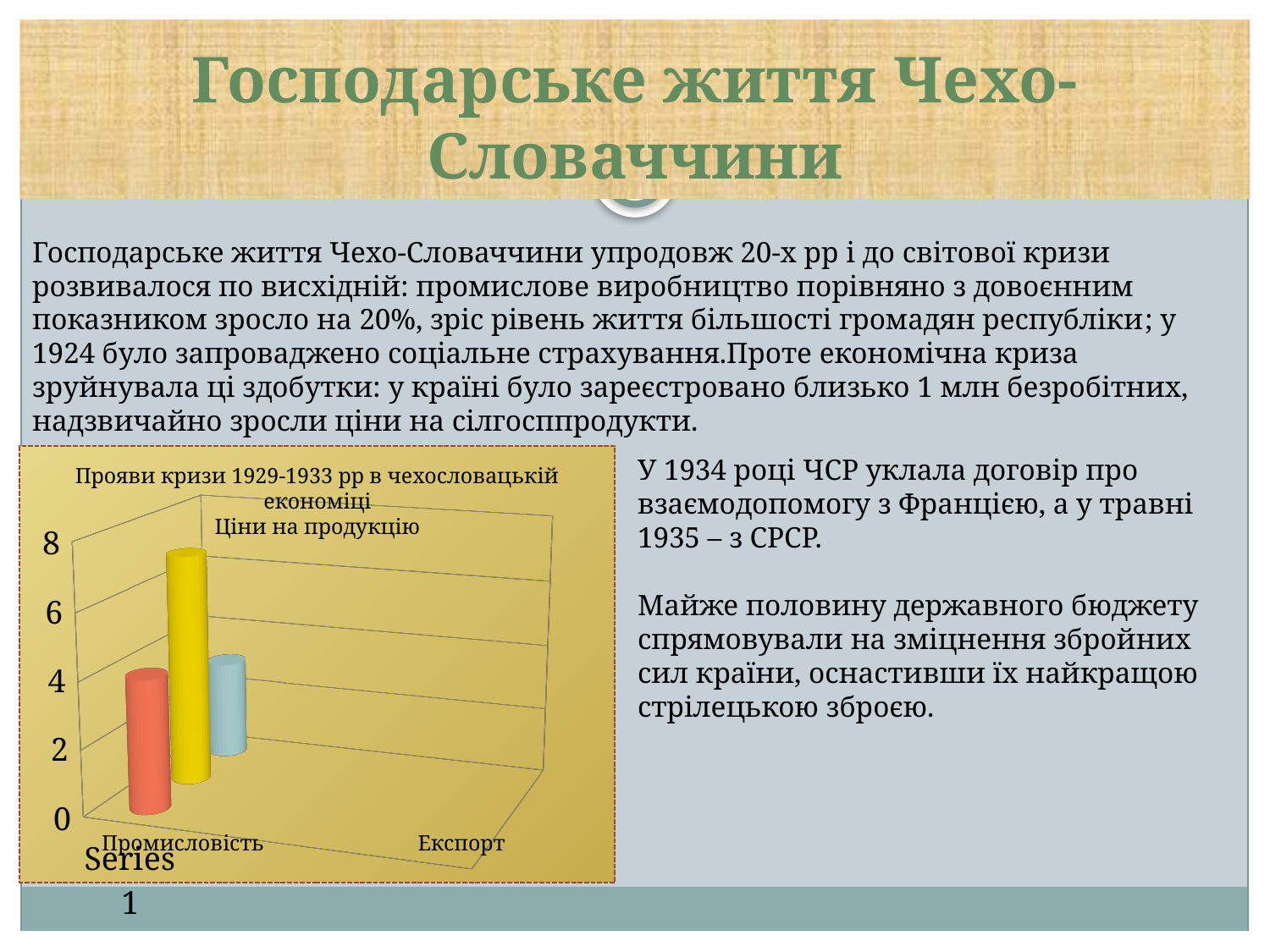
What is the highest tick value shown on the vertical axis of the chart? 8 Which is larger, the value for Ціни на продукцію or the value for Експорт? Ціни на продукцію How many series does the chart's legend list? 1 Is the value for Промисловість greater or less than 6? less What type of chart is shown on the slide? bar chart Which category has the highest bar in the chart? Ціни на продукцію Is the value for Ціни на продукцію greater or less than 6? greater Is the value for Експорт greater or less than 6? less What is the title of the chart on the slide? Прояви кризи 1929-1933 рр в чехословацькій економіці Which is larger, the value for Ціни на продукцію or the value for Промисловість? Ціни на продукцію How many bars are plotted in the chart? 3